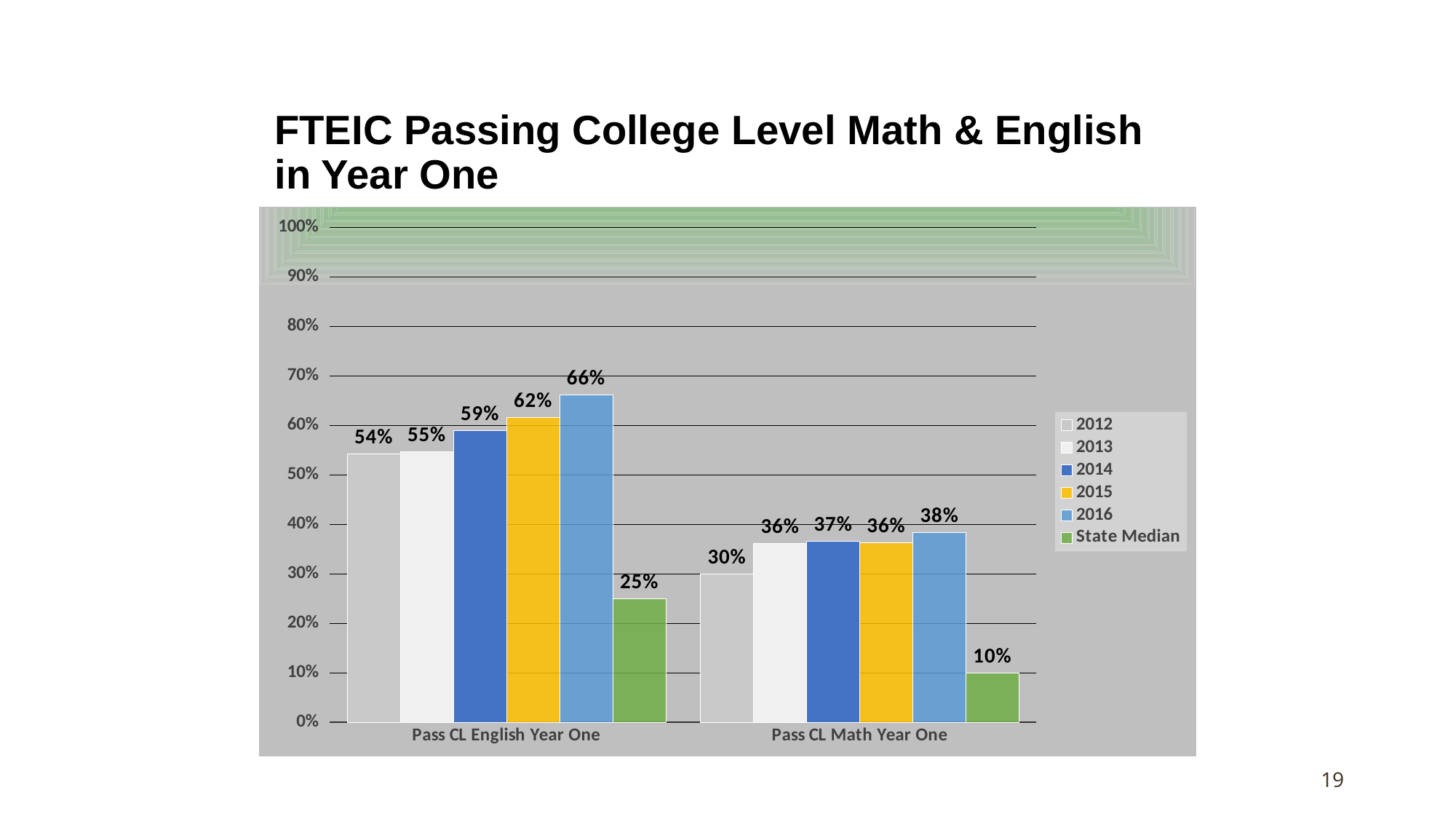
What is the difference between the 2016 value and the 2012 value for Pass CL Math Year One? 8% What is the difference between the 2016 value and the State Median value for Pass CL English Year One? 41% Which series has the highest value in the Pass CL English Year One category? 2016 What is the value for 2012 in the Pass CL Math Year One category? 30% How many categories are shown on the x axis? 2 Do the values from 2012 to 2016 rise or fall in the Pass CL English Year One category? Rise Which series has the lowest value in the Pass CL Math Year One category? State Median Which is larger: the 2015 value for Pass CL English Year One or the 2015 value for Pass CL Math Year One? Pass CL English Year One What is the State Median value for Pass CL Math Year One? 10% How many series does the legend list? 6 What is the value for 2016 in the Pass CL English Year One category? 66% What kind of chart is shown on the slide? Bar chart